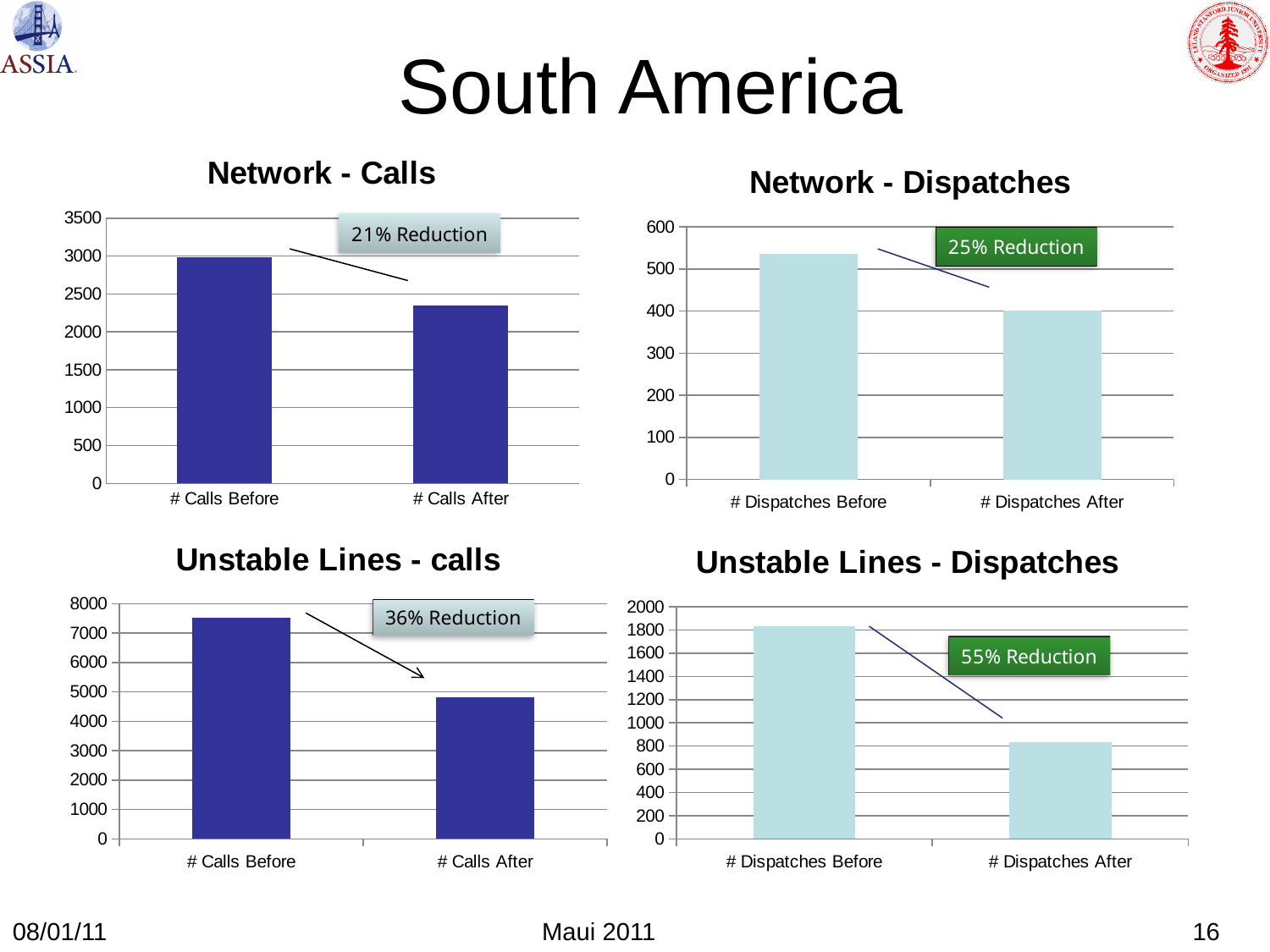
In the Network - Calls chart, is the value for # Calls After greater or less than 2500? less What kind of chart is the Network - Dispatches chart? bar chart In the Network - Calls chart, is the value for # Calls Before greater or less than 2500? greater What percentage reduction is annotated on the Unstable Lines - Dispatches chart? 55% Reduction How many categories are shown in the Unstable Lines - calls chart? 2 In the Network - Calls chart, which is larger, # Calls Before or # Calls After? # Calls Before In the Unstable Lines - calls chart, is the value for # Calls After greater or less than 5000? less In the Network - Dispatches chart, which category has the lowest value? # Dispatches After In the Unstable Lines - Dispatches chart, do the values rise or fall from # Dispatches Before to # Dispatches After? fall